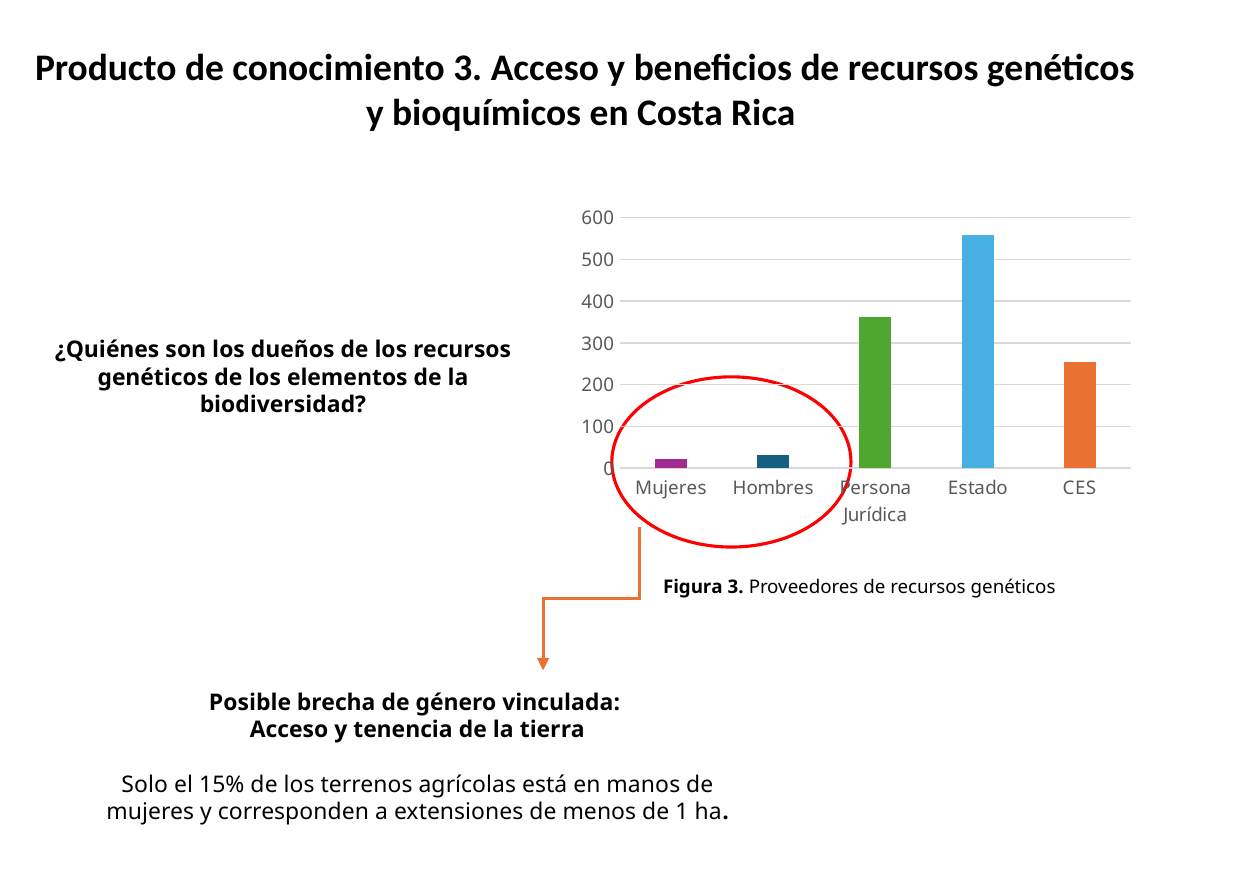
Is the value for CES greater or less than 200? greater Is the value for Persona Jurídica greater or less than 300? greater Is the value for CES greater or less than 300? less Which category has the highest bar in the chart? Estado Which is larger, the value for Estado or the value for Persona Jurídica? Estado How many categories are shown on the x axis of the chart? 5 What is the caption of the figure shown on the slide? Figura 3. Proveedores de recursos genéticos What kind of chart is shown on the slide? bar chart Which is larger, the value for Persona Jurídica or the value for CES? Persona Jurídica